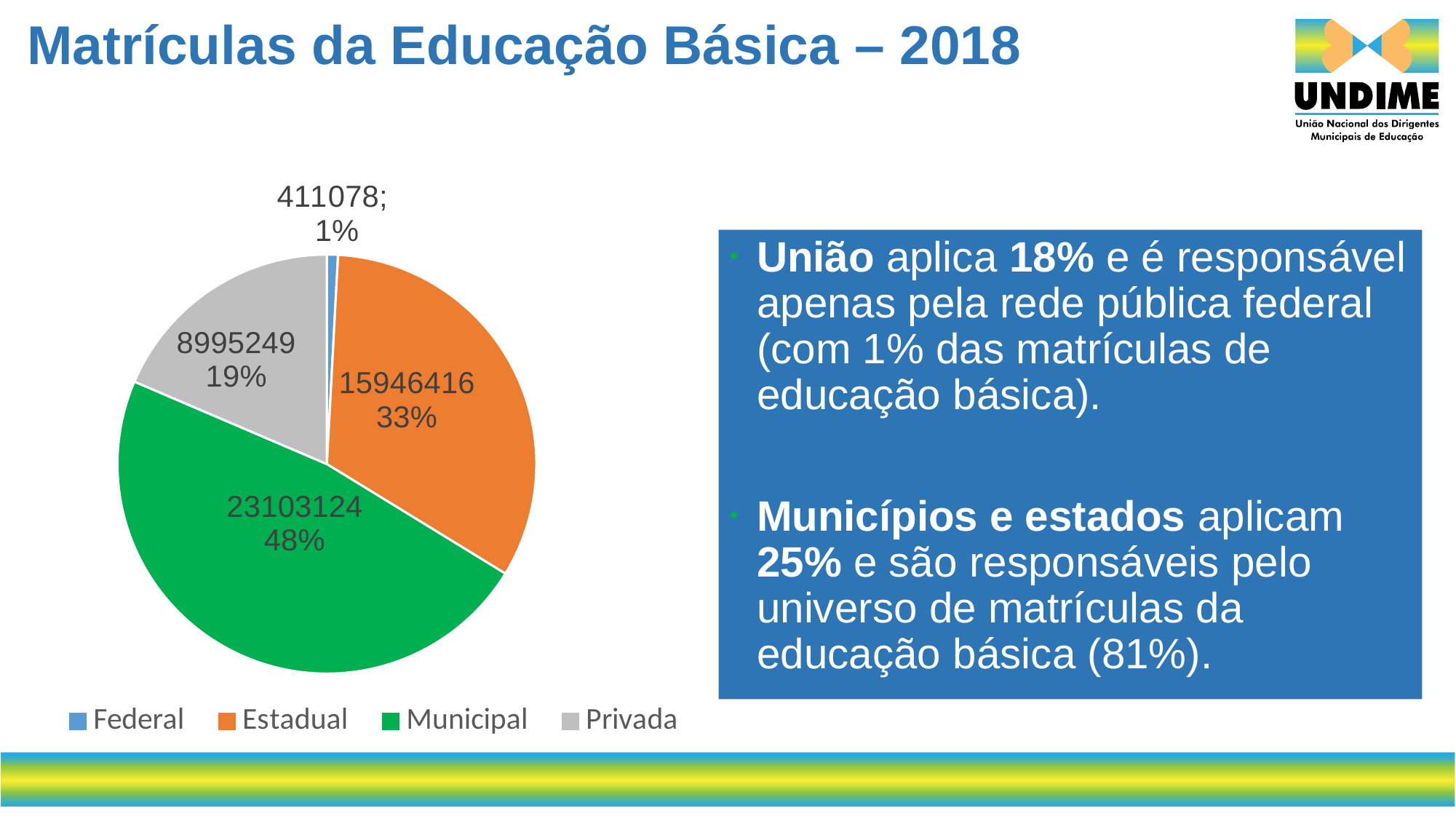
Which slice is larger, Estadual or Privada? Estadual What is the number of enrolments shown for the Estadual slice? 15946416 How many slices does the pie chart have? 4 Which category has the largest slice of the pie? Municipal What type of chart is shown on the slide? Pie chart Which category has the smallest slice of the pie? Federal What is the difference in enrolments between the Municipal and Estadual slices? 7156708 How many entries does the legend of the pie chart list? 4 What is the number of enrolments shown for the Privada slice? 8995249 What is the number of enrolments shown for the Federal slice? 411078 What is the number of enrolments shown for the Municipal slice? 23103124 What share of the pie does the Privada slice represent? 19%